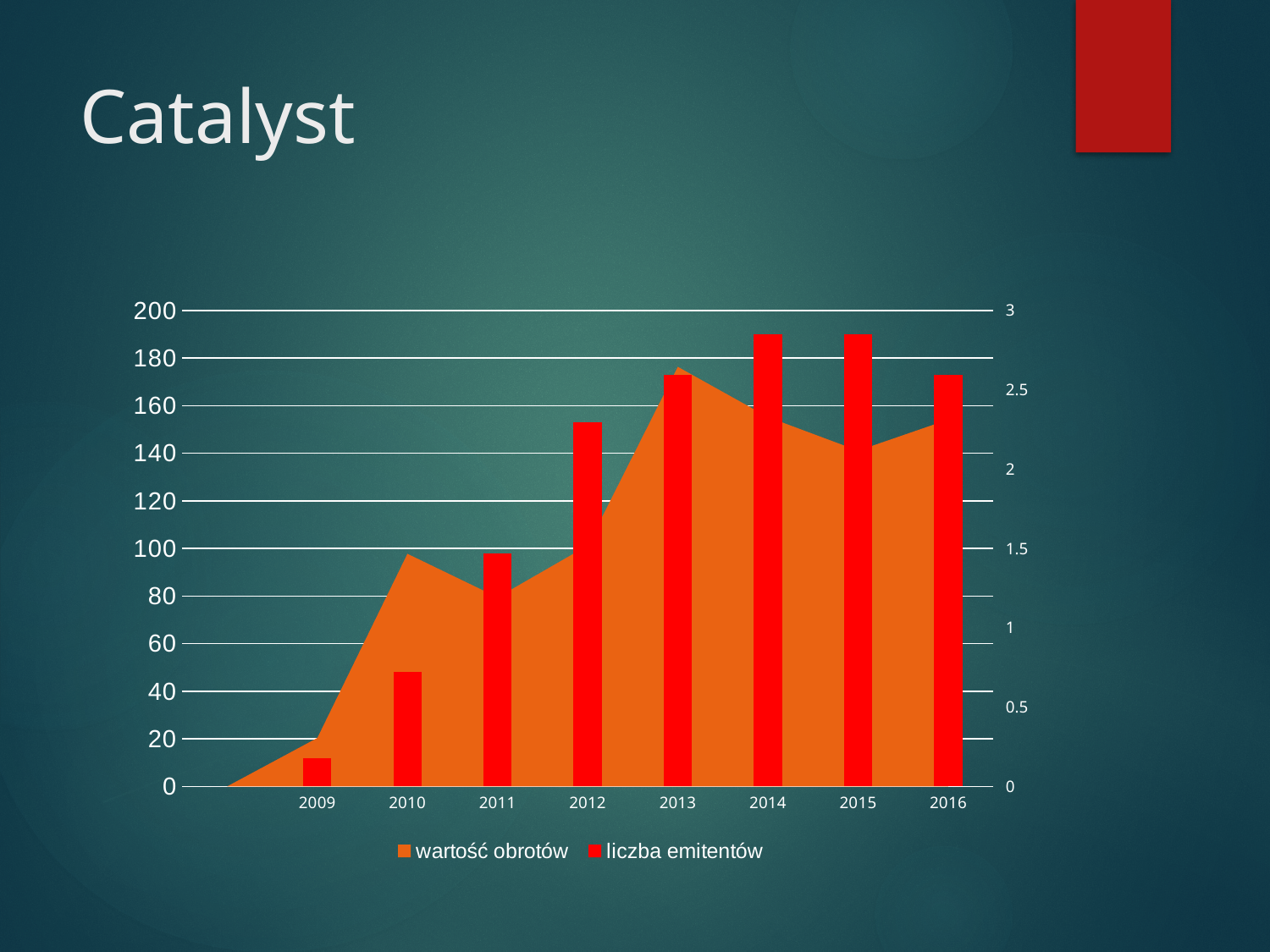
How many series does the legend list? 2 In which year is the liczba emitentów bar lowest? 2009 Do the liczba emitentów bars rise or fall from 2009 to 2014? rise Which year has the larger wartość obrotów value, 2013 or 2015? 2013 In which year does the wartość obrotów area reach its highest point? 2013 How many years are shown on the x axis? 8 Which series is drawn as the orange area? wartość obrotów Which series is drawn as red bars? liczba emitentów What kind of chart is this? A combination chart with an area series and a bar series